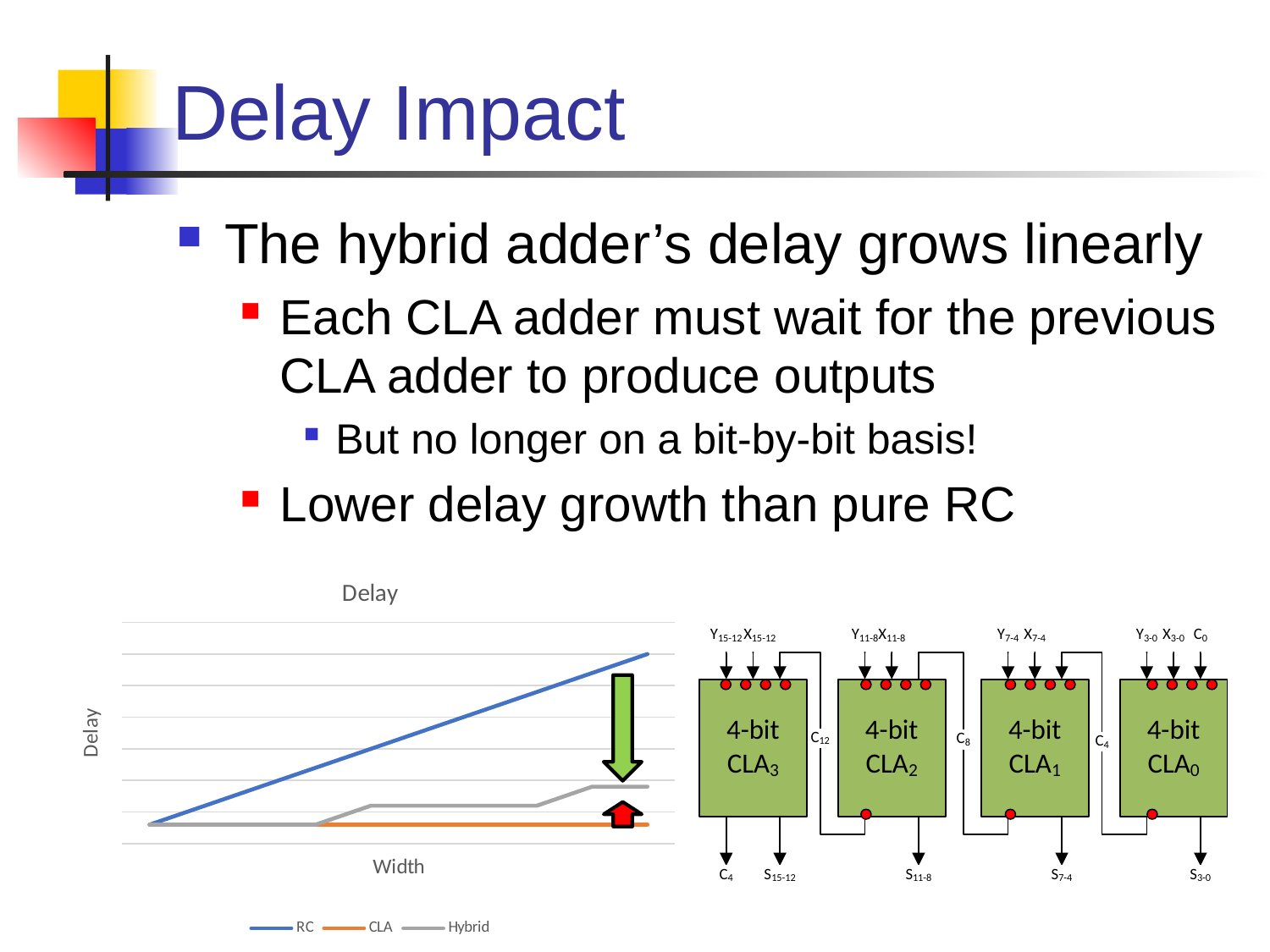
In the "Delay" chart, does the CLA series rise, fall, or stay flat as Width increases? stay flat Which series are listed in the legend of the "Delay" chart? RC, CLA, Hybrid What kind of chart is the "Delay" chart on the slide? line chart In the "Delay" chart, at the largest width, which series has the larger delay: Hybrid or CLA? Hybrid What is the title of the line chart on the slide? Delay How many series does the legend of the "Delay" chart list? 3 In the "Delay" chart, does the RC series rise or fall as Width increases? rise In the "Delay" chart, at the largest width, which series has the larger delay: RC or Hybrid? RC In the "Delay" chart, does the Hybrid series rise or fall overall as Width increases? rise In the "Delay" chart, which series has the lowest delay at the largest width? CLA What is the label of the horizontal axis of the "Delay" chart? Width In the "Delay" chart, which series reaches the highest delay at the largest width? RC